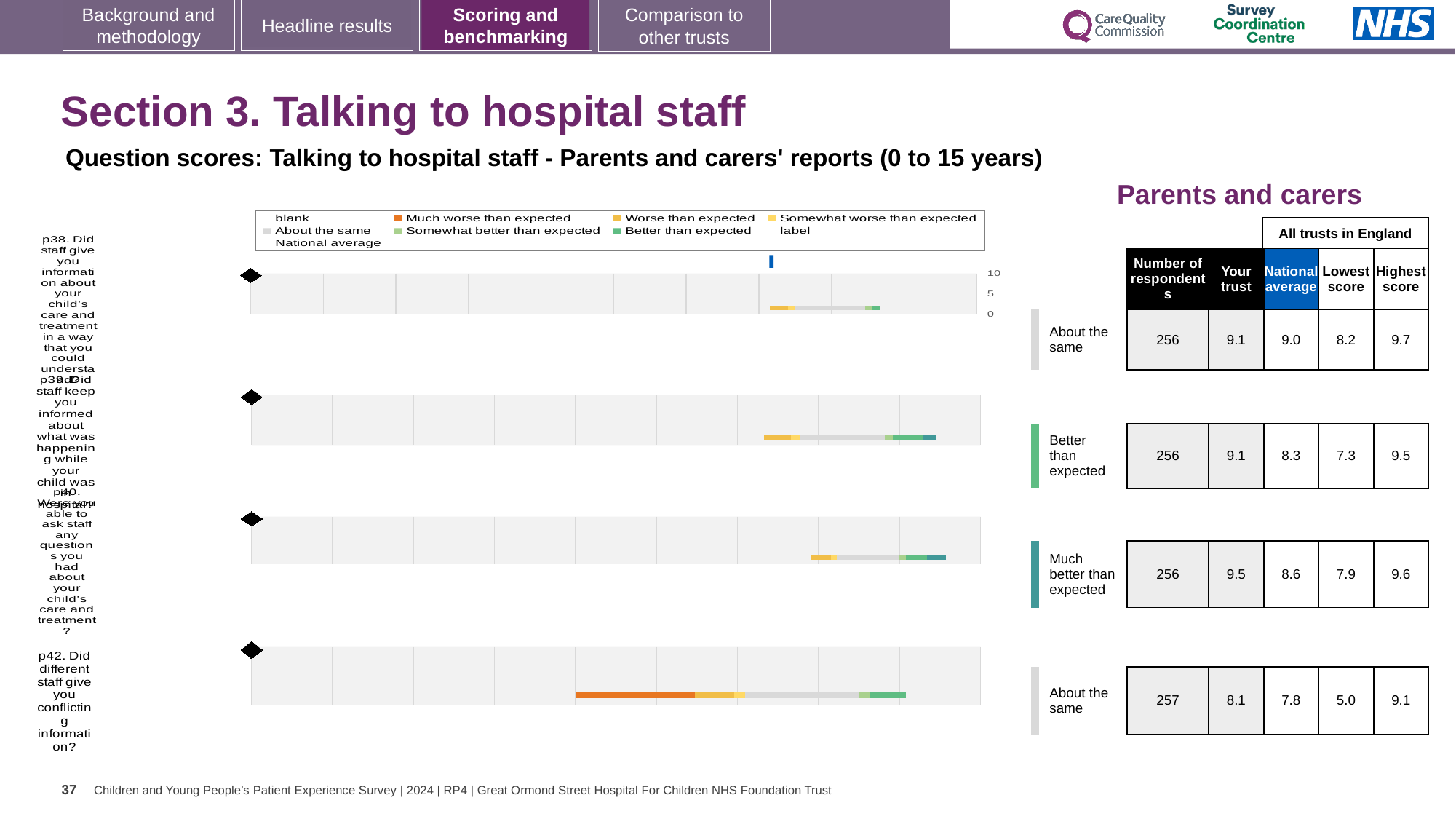
For the p40 chart (able to ask staff any questions), what is the 'Your trust' score? 9.5 For the p38 chart (information about care and treatment), what is the highest score among all trusts in England? 9.7 Which question has the highest 'Your trust' score? p40 For the p39 chart, which is larger: the 'Your trust' score or the national average? Your trust What benchmark category is shown next to the p40 chart? Much better than expected What kind of chart is used to show the question scores on this slide? bar chart What benchmark category is shown next to the p39 chart? Better than expected How many question score charts are shown on the slide? 4 For the p39 chart (kept informed while child was in hospital), how many respondents are there? 256 For the p42 chart (conflicting information), what is the national average score? 7.8 Which question has the lowest 'Your trust' score? p42 For the p42 chart, what is the difference between the highest score and the lowest score among all trusts in England? 4.1